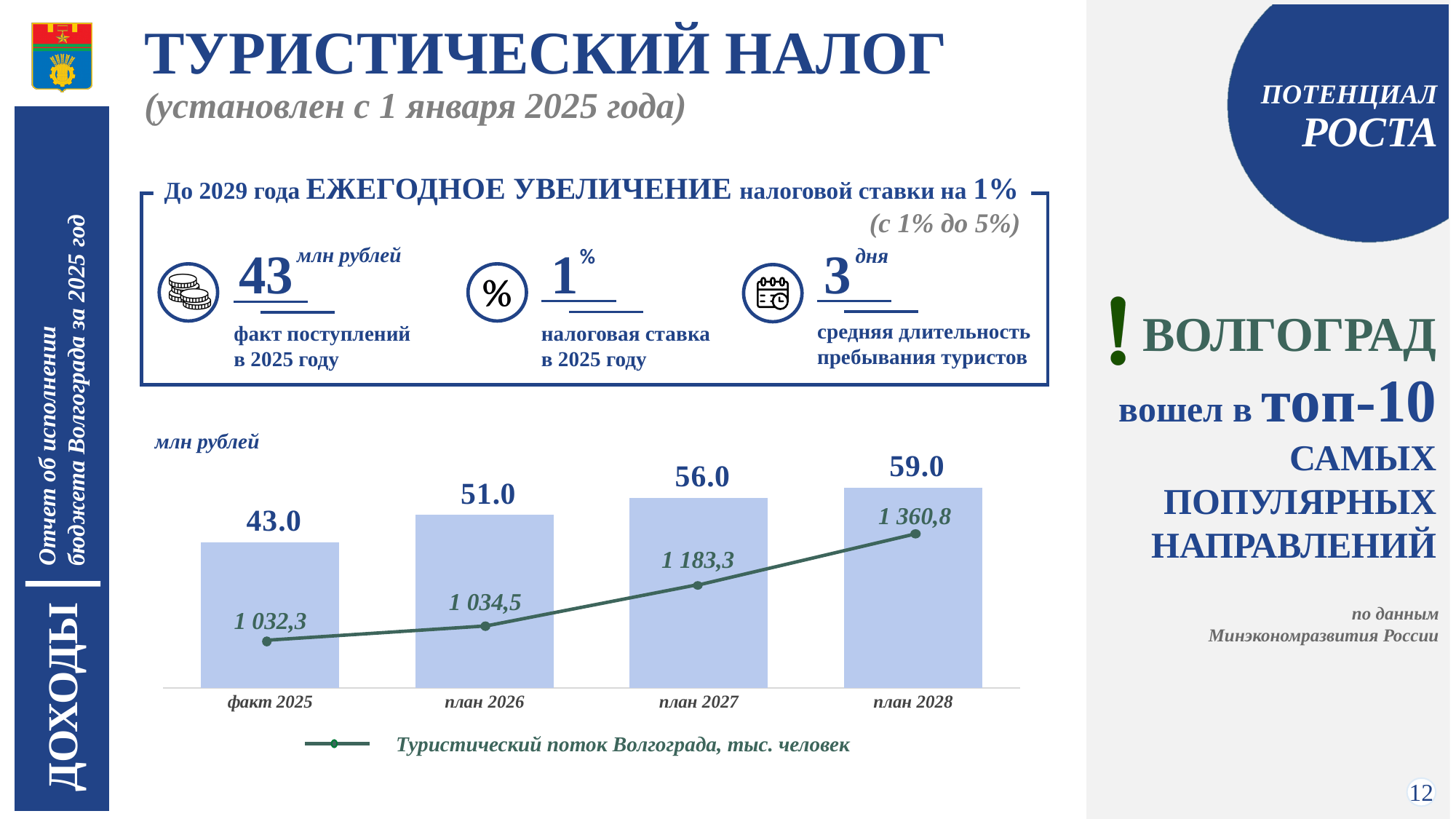
Do the bar values rise or fall from факт 2025 to план 2028? Rise Which category has the highest bar value? план 2028 Which category has the lowest value on the line 'Туристический поток Волгограда, тыс. человек'? факт 2025 What is the value of the line 'Туристический поток Волгограда, тыс. человек' for план 2028? 1 360,8 What is the value of the line 'Туристический поток Волгограда, тыс. человек' for план 2027? 1 183,3 Which is larger: the bar value for план 2027 or for план 2026? план 2027 What kind of chart is shown on the slide? Combined bar and line chart How many categories are shown on the x axis of the chart? 4 What is the bar value for факт 2025? 43.0 What is the difference between the bar values for план 2028 and факт 2025? 16.0 How many series does the chart's legend list? 1 What is the bar value for план 2026? 51.0